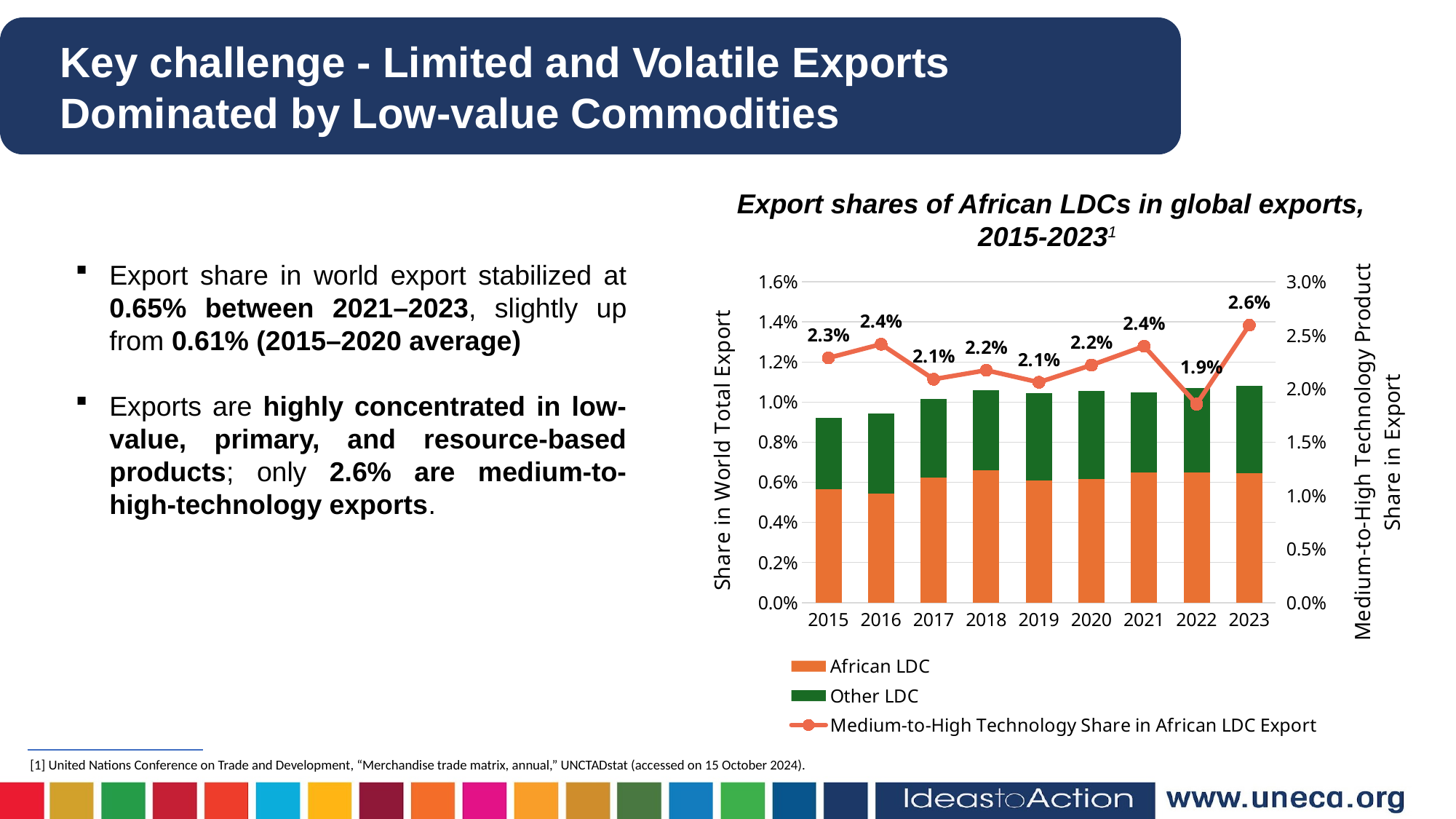
How many years are shown on the x axis of the chart? 9 In which year is the Medium-to-High Technology Share in African LDC Export highest? 2023 What kind of chart is shown on the slide? Stacked bar chart with a line Is the total stacked bar (African LDC plus Other LDC) for 2023 greater or less than 1.0% on the left axis? greater By how many percentage points did the Medium-to-High Technology Share in African LDC Export change from 2022 to 2023? 0.7 percentage points What is the Medium-to-High Technology Share in African LDC Export for 2022? 1.9% Which year has a higher Medium-to-High Technology Share in African LDC Export, 2016 or 2017? 2016 How many series does the chart's legend list? 3 What is the Medium-to-High Technology Share in African LDC Export for 2015? 2.3% In which year is the Medium-to-High Technology Share in African LDC Export lowest? 2022 What is the Medium-to-High Technology Share in African LDC Export for 2023? 2.6% Is the total stacked bar (African LDC plus Other LDC) for 2015 greater or less than 1.0% on the left axis? less